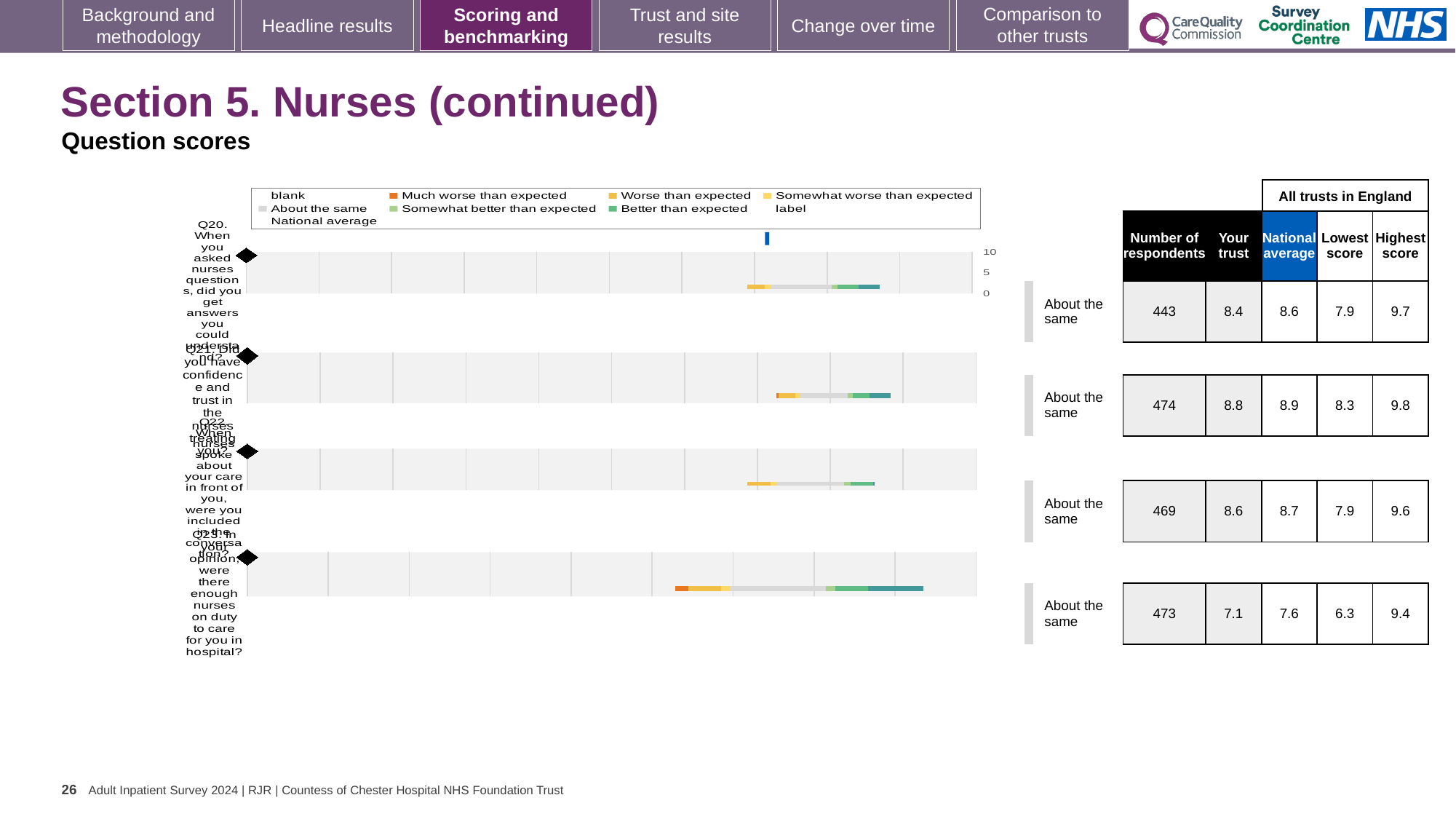
How many questions (bars) are plotted on the chart? 4 For Q20, which is larger: the 'Your trust' score or the national average? National average For Q23, what is the difference between the highest score and the lowest score among all trusts in England? 3.1 What is the highest score among all trusts in England for Q21? 9.8 What is the national average score for Q21? 8.9 What is the 'Your trust' score for Q23? 7.1 How many respondents answered Q20? 443 Which question has the highest 'Your trust' score? Q21 Which question has the lowest 'Your trust' score? Q23 For Q22, how much higher is the national average than the 'Your trust' score? 0.1 What benchmark category is shown for Q23? About the same What kind of chart is shown on the slide? bar chart